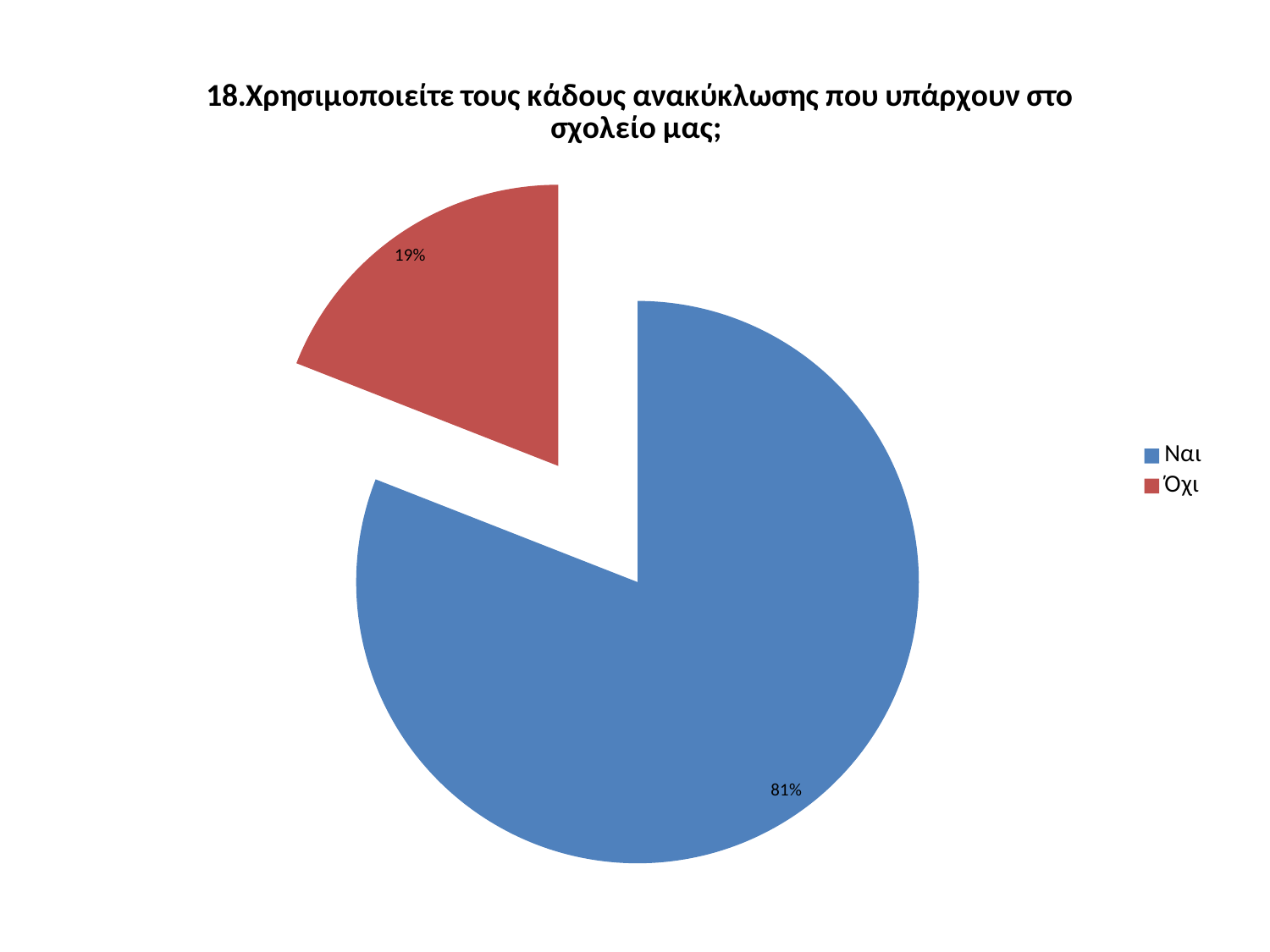
What is the difference in percentage points between the "Ναι" and "Όχι" slices? 62 Which slice is larger, "Ναι" or "Όχι"? Ναι What type of chart is shown on the slide? Pie chart Which category has the largest share of the pie? Ναι What is the title of the chart? 18.Χρησιμοποιείτε τους κάδους ανακύκλωσης που υπάρχουν στο σχολείο μας; How many entries does the legend list? 2 How many slices does the pie chart have? 2 What percentage of the pie does the "Ναι" slice represent? 81% Which category has the smallest share of the pie? Όχι What percentage of the pie does the "Όχι" slice represent? 19% What colour is the "Όχι" slice? Red